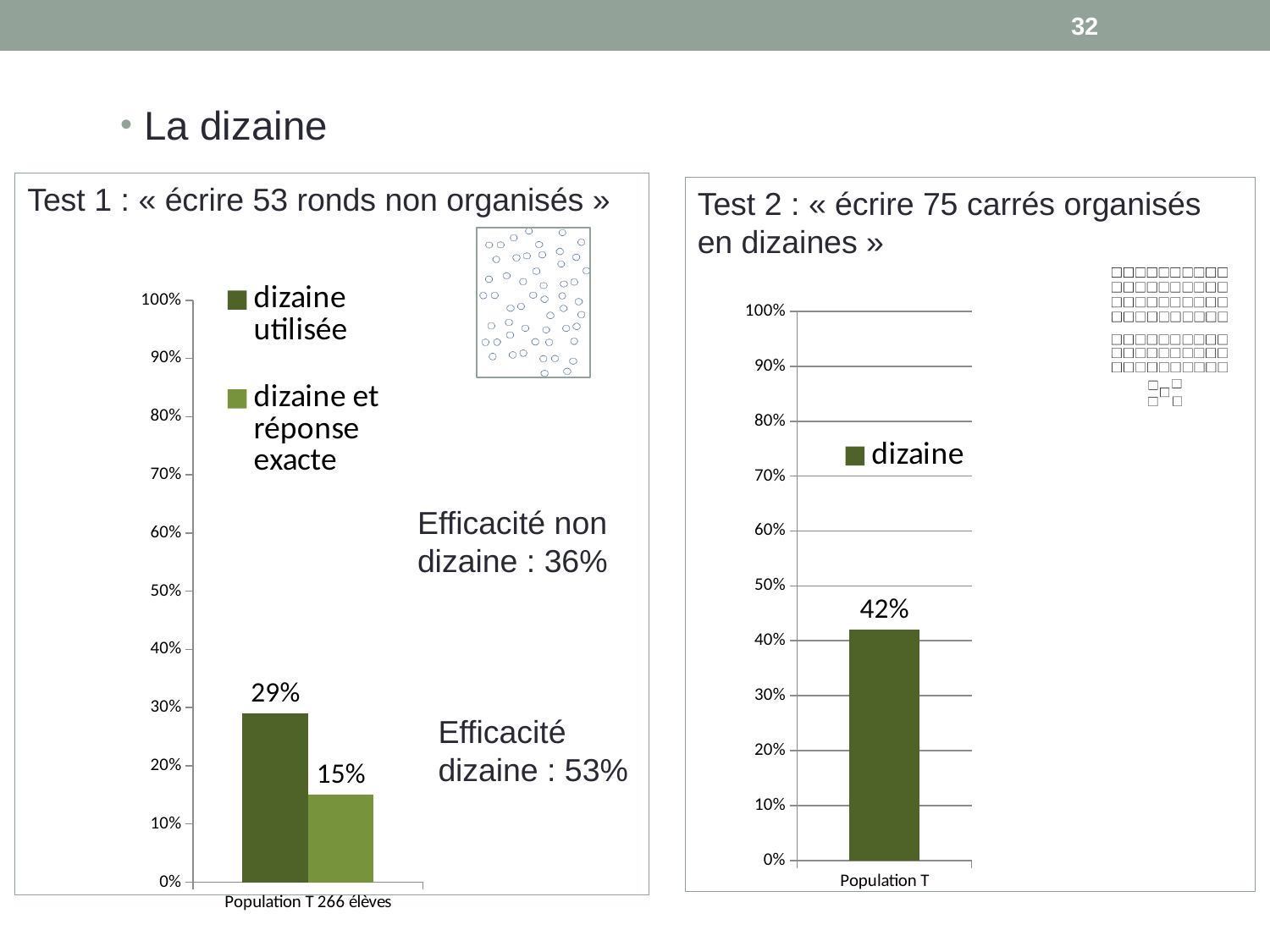
What kind of chart is the Test 2 chart on the right? Bar chart What is the maximum value shown on the y axis of the Test 2 chart on the right? 100% How many series does the legend of the Test 1 chart on the left list? 2 In the Test 1 chart on the left, what is the value for "dizaine utilisée"? 29% How many series does the legend of the Test 2 chart on the right list? 1 In the Test 1 chart on the left, what is the difference between "dizaine utilisée" and "dizaine et réponse exacte"? 14% What is the category label on the x axis of the Test 1 chart on the left? Population T 266 élèves In the Test 2 chart on the right, what is the value for "dizaine" for Population T? 42% In the Test 2 chart on the right, is the value for "dizaine" greater or less than 50%? less In the Test 1 chart on the left, which series has the higher value? dizaine utilisée In the Test 1 chart on the left, what is the value for "dizaine et réponse exacte"? 15% Is the "dizaine" value in the Test 2 chart on the right larger than the "dizaine utilisée" value in the Test 1 chart on the left? Yes